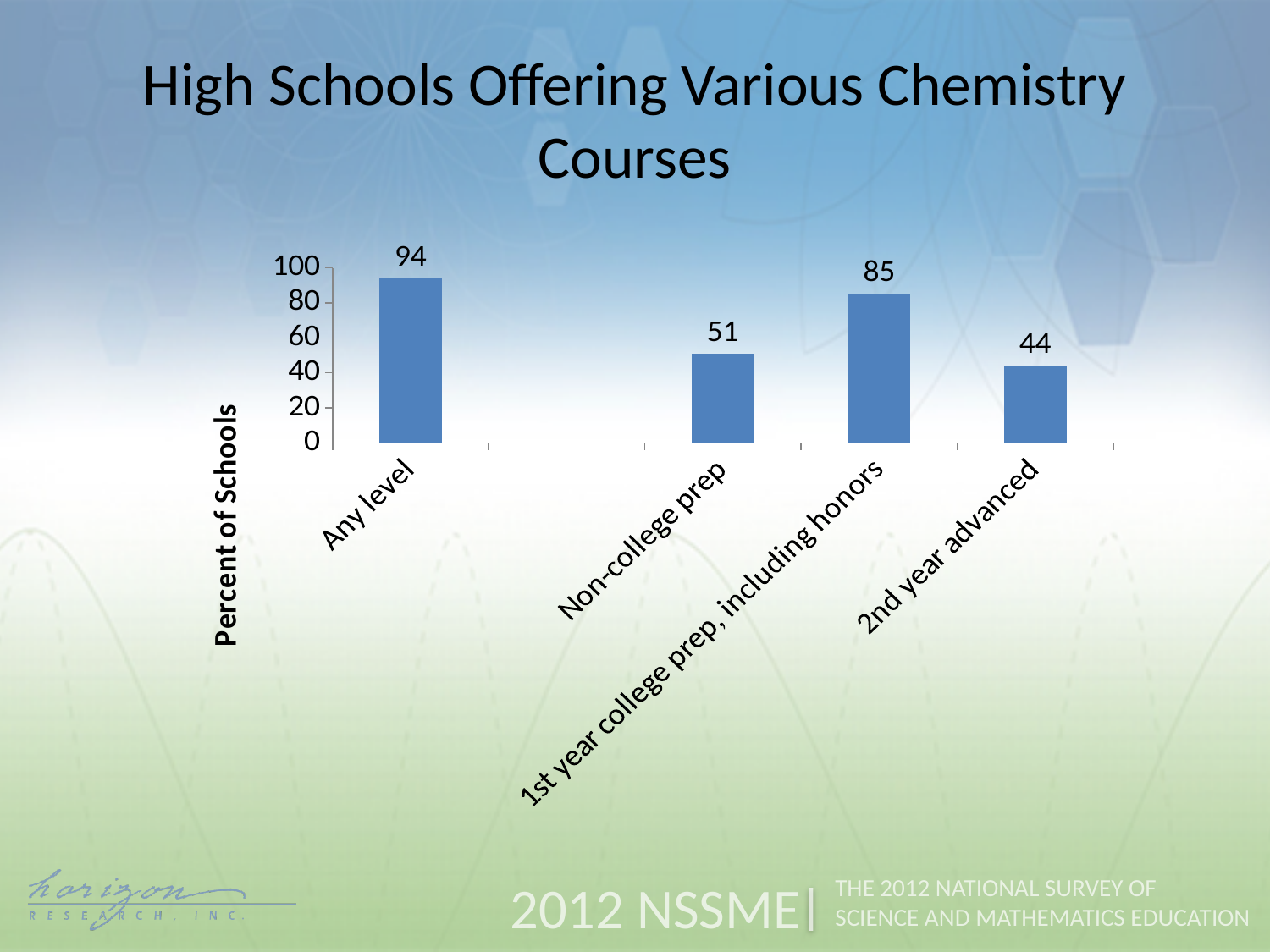
Is the value for 1st year college prep, including honors greater or less than 80? greater What kind of chart is shown on the slide? Bar chart What percent of high schools offer chemistry at any level? 94 What is the difference between the values for 1st year college prep, including honors and Non-college prep? 34 What is the value for 2nd year advanced chemistry? 44 Which chemistry course category has the highest percent of schools? Any level Which is larger, the value for Non-college prep or the value for 2nd year advanced? Non-college prep How many course categories are shown in the chart? 4 What is the value for 1st year college prep, including honors? 85 Which chemistry course category has the lowest percent of schools? 2nd year advanced What is the difference between the values for Any level and 2nd year advanced? 50 What is the value for Non-college prep chemistry? 51